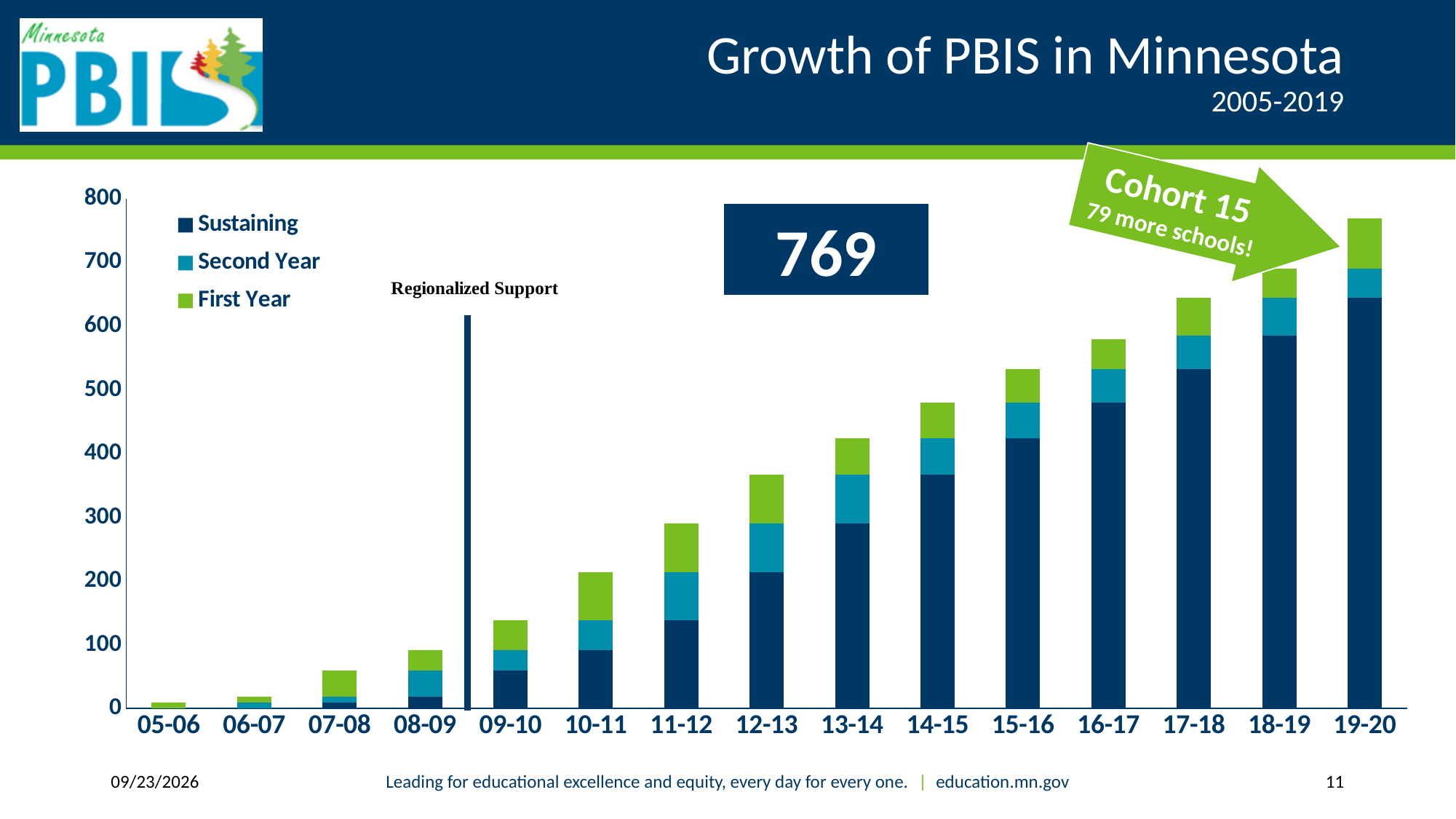
What are the three legend entries of the chart? Sustaining, Second Year, First Year Is the total for 19-20 greater or less than 700? greater How many series does the legend list? 3 Is the total for 13-14 greater or less than 400? greater Which is larger, the Sustaining segment for 19-20 or the Sustaining segment for 18-19? 19-20 Which school year has the tallest stacked bar? 19-20 Which school year has the shortest stacked bar? 05-06 Do the total bar heights rise or fall from 05-06 to 19-20? rise What kind of chart is shown on the slide? stacked bar chart How many school-year categories are shown on the x axis? 15